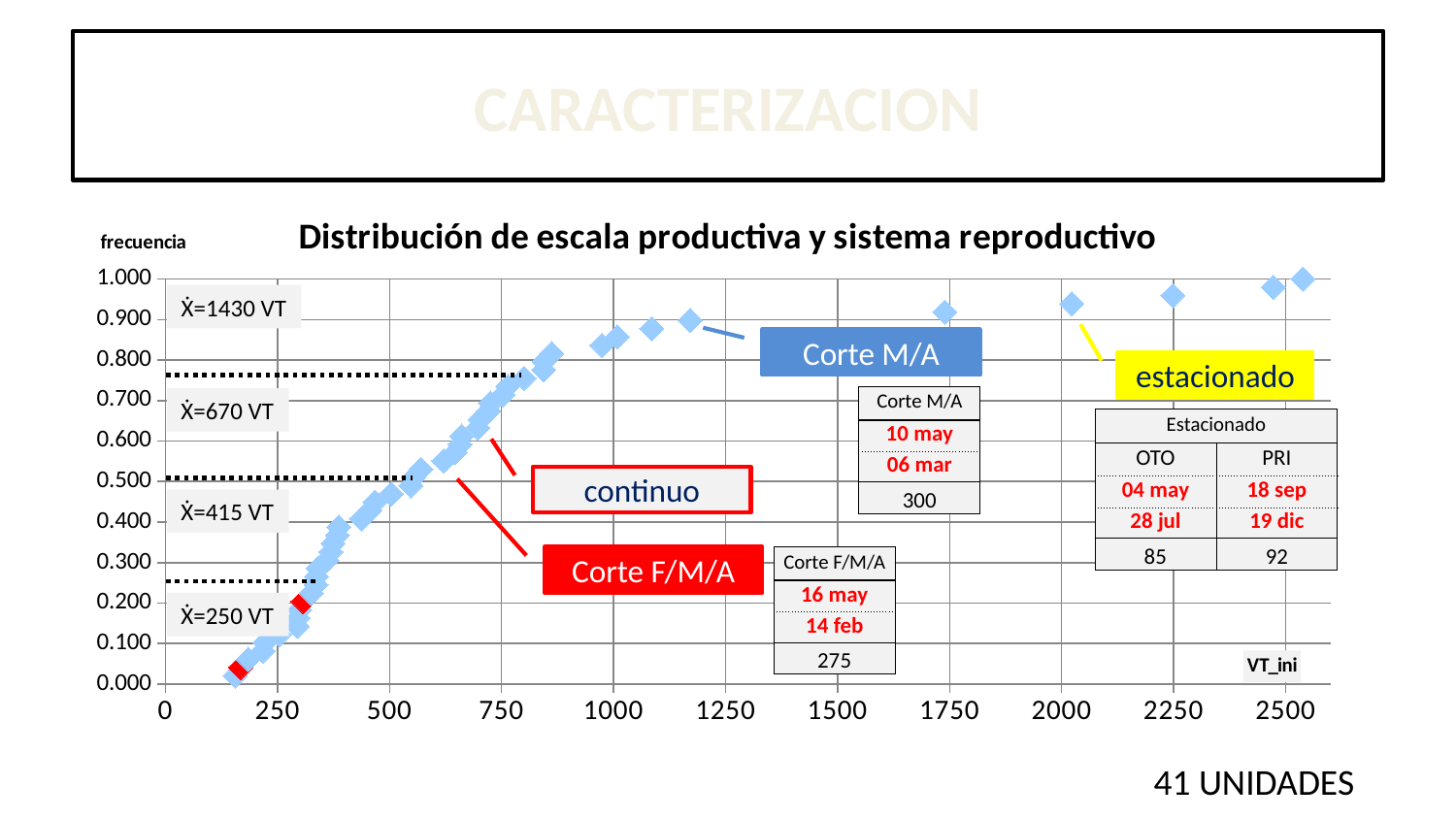
What mean value (Ẋ) is annotated for the lowest group of points on the chart? Ẋ=250 VT What label is shown on the x axis of the chart? VT_ini What value is shown in the bottom row of the Corte M/A table on the chart? 300 Is the frecuencia value for the point at about 2500 VT_ini greater or less than 0.900? greater What mean value (Ẋ) is annotated for the highest group of points on the chart? Ẋ=1430 VT Is the frecuencia value for the point at about 1750 VT_ini greater or less than 0.800? greater Do the plotted values rise or fall as VT_ini increases along the x axis? rise How many units does the slide say the distribution covers? 41 UNIDADES Is the frecuencia value for the point at about 1000 VT_ini greater or less than 0.700? greater What kind of chart is shown on the slide? scatter chart What is the title of the chart? Distribución de escala productiva y sistema reproductivo